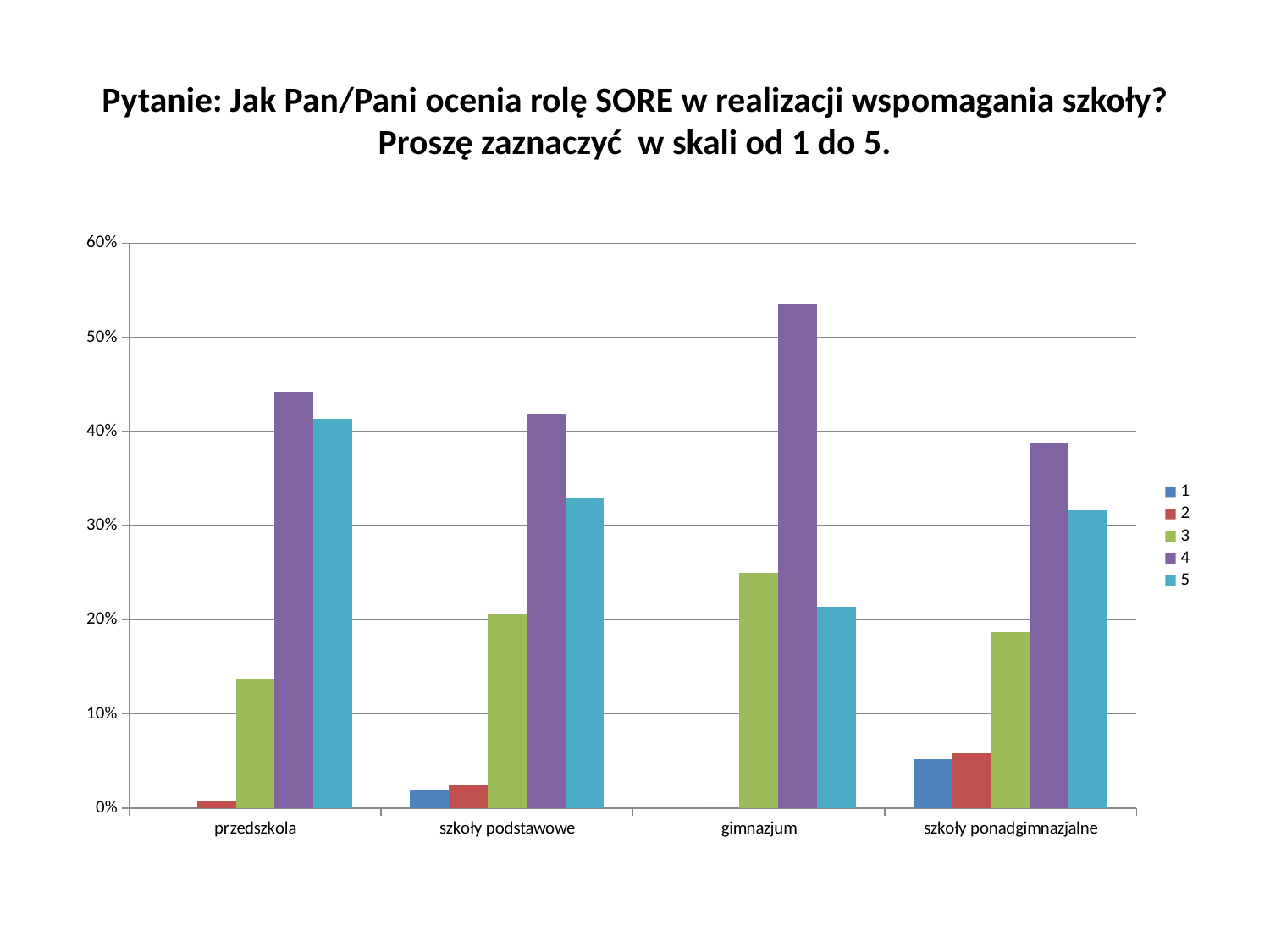
Which category has the highest value for series 1? szkoły ponadgimnazjalne Which is larger: the value for series 3 in przedszkola or in szkoły podstawowe? szkoły podstawowe Which category has the lowest value for series 3? przedszkola How many categories are shown on the x axis? 4 How many series does the legend list? 5 Which category has the highest value for series 4? gimnazjum What entries are listed in the legend? 1, 2, 3, 4, 5 In the gimnazjum category, which series has the highest value? 4 Is the value for series 3 in szkoły ponadgimnazjalne greater or less than 20%? less What kind of chart is shown on the slide? bar chart Is the value for series 4 in gimnazjum greater or less than 50%? greater Is the value for series 5 in przedszkola greater or less than 40%? greater